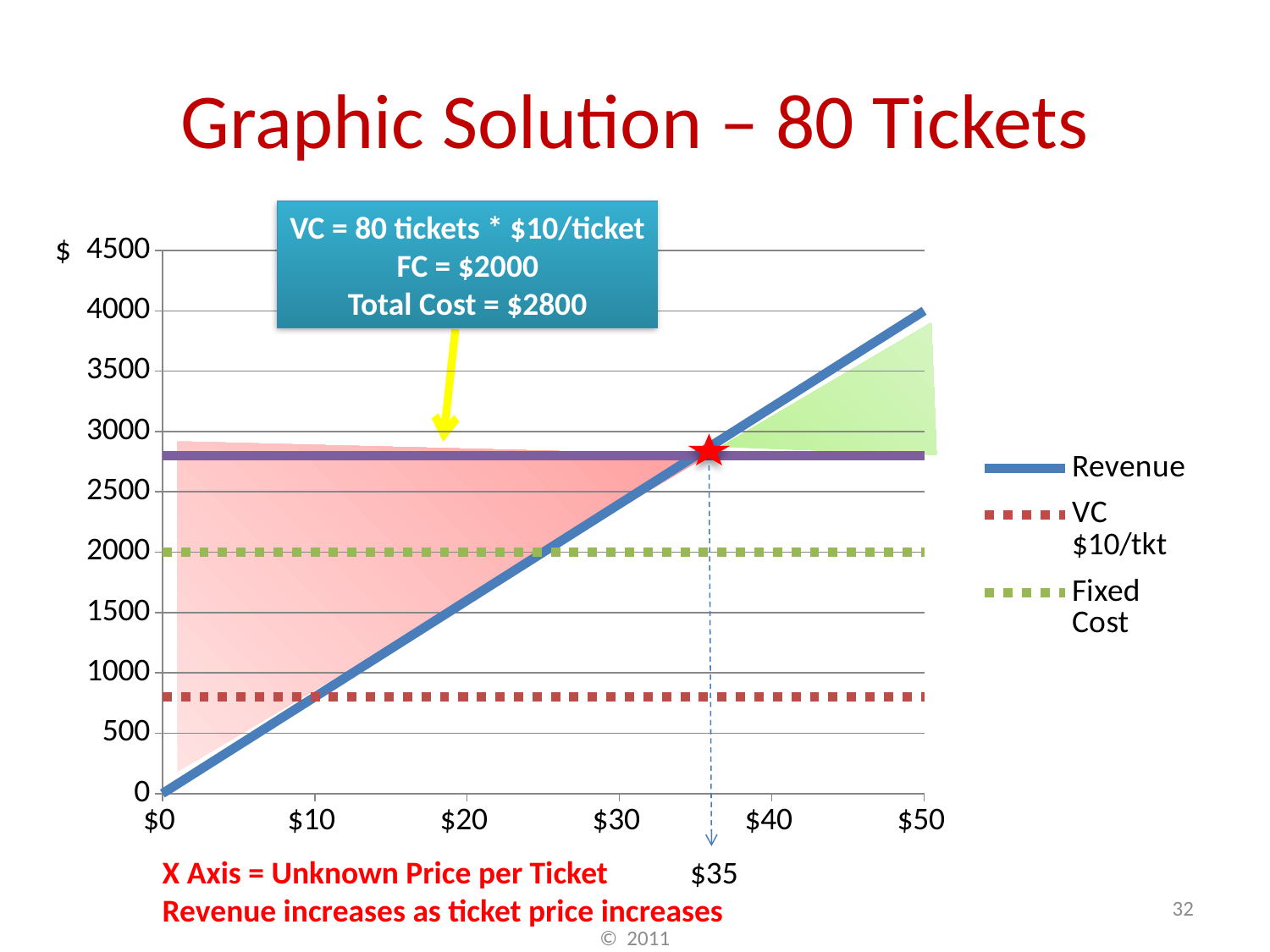
Does Revenue rise or fall as the ticket price increases along the x axis? rises What kind of chart is shown on the slide? line chart Is the Revenue value at a ticket price of $10 greater or less than 1000? less Which series are listed in the chart legend? Revenue, VC $10/tkt, Fixed Cost What is the value of the Fixed Cost line? $2000 What is the title of the slide containing the chart? Graphic Solution – 80 Tickets How many series does the chart legend list? 3 What is the Total Cost shown in the callout box? $2800 Which line is higher on the chart, Fixed Cost or VC $10/tkt? Fixed Cost Is the value of the VC $10/tkt line greater or less than 1000? less At what ticket price does the Revenue line cross the total cost line (marked by the star)? $35 Is the Revenue value at a ticket price of $50 greater or less than 3500? greater